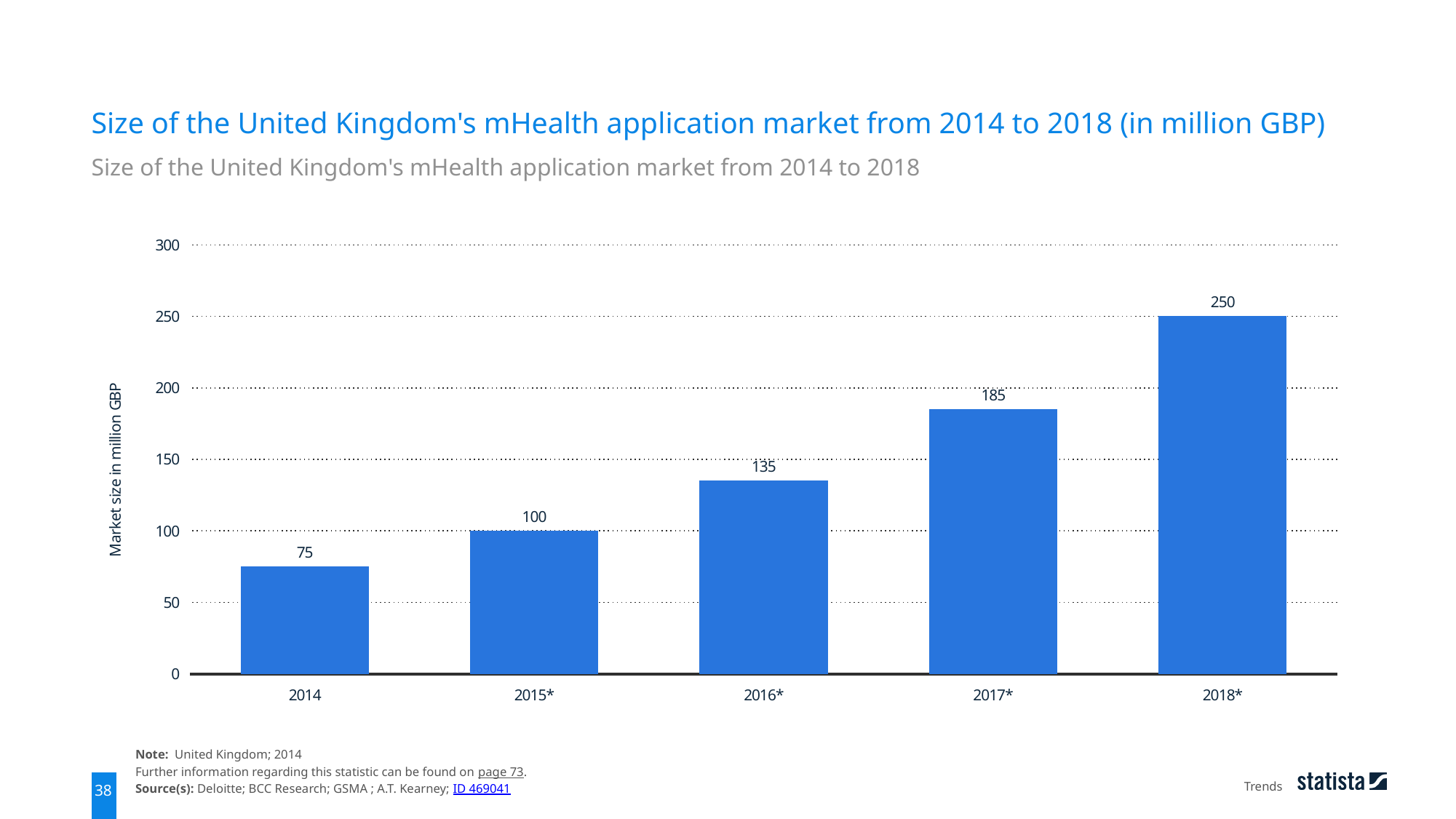
Is the value for 2017* greater or less than 200? less What kind of chart is shown on the slide? bar chart Do the values rise or fall from 2014 to 2018*? rise What is the difference between the market size in 2018* and 2017*? 65 Which is larger, the market size in 2016* or in 2017*? 2017* Which year has the highest market size? 2018* What is the market size for 2018*? 250 What is the market size for 2014? 75 How many years are shown on the x axis? 5 Which year has the lowest market size? 2014 What is the market size for 2016*? 135 What is the difference between the market size in 2015* and 2014? 25